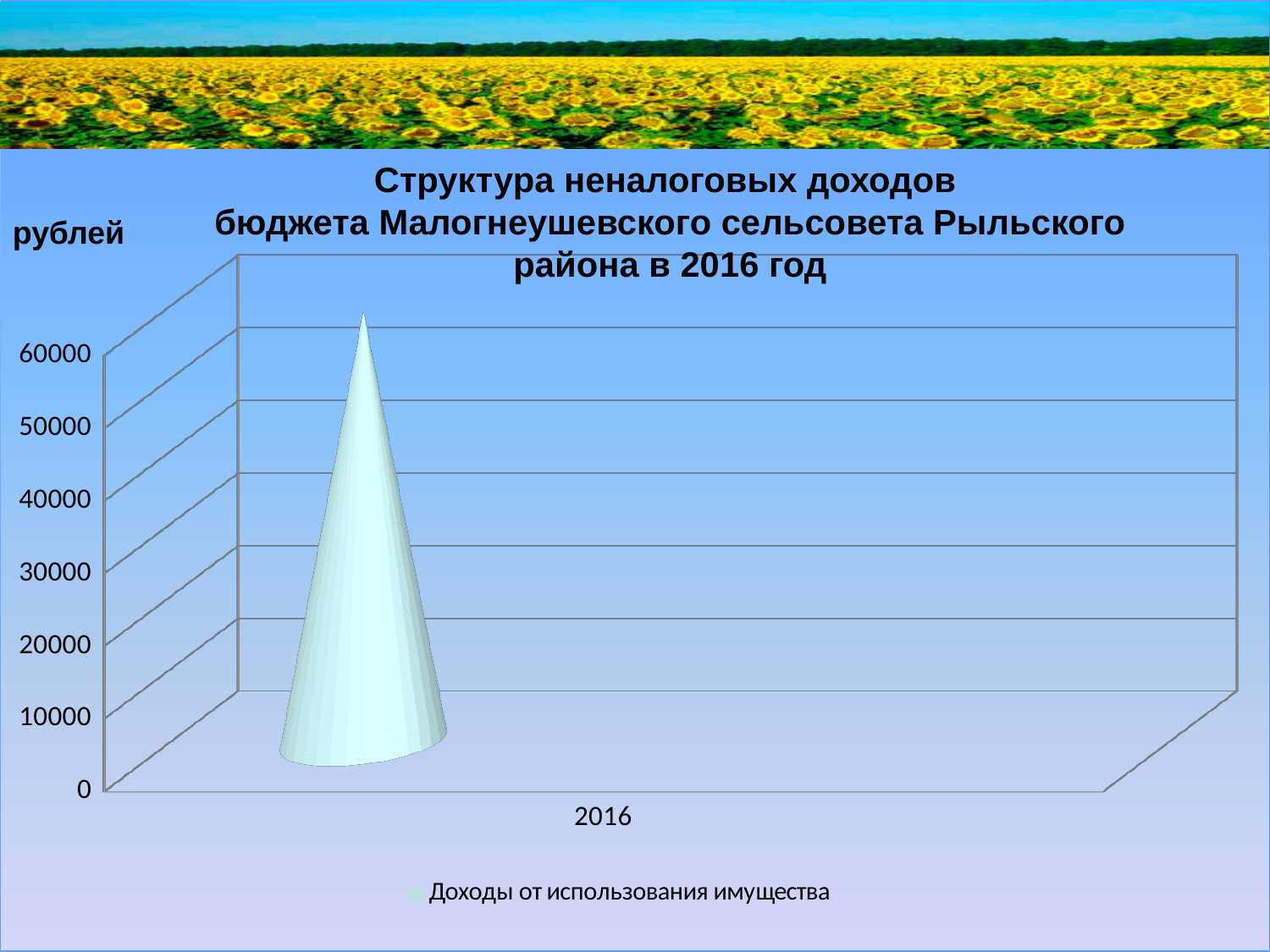
How many series does the chart legend list? 1 Is the value for Доходы от использования имущества in 2016 greater or less than 30000? greater What is the highest tick value shown on the vertical axis of the chart? 60000 How many categories are shown on the x axis of the chart? 1 What unit is indicated for the vertical axis of the chart? рублей What category label is shown on the x axis of the chart? 2016 What is the name of the series listed in the chart legend? Доходы от использования имущества What kind of chart is shown on the slide? bar chart Is the value for Доходы от использования имущества in 2016 greater or less than 50000? greater